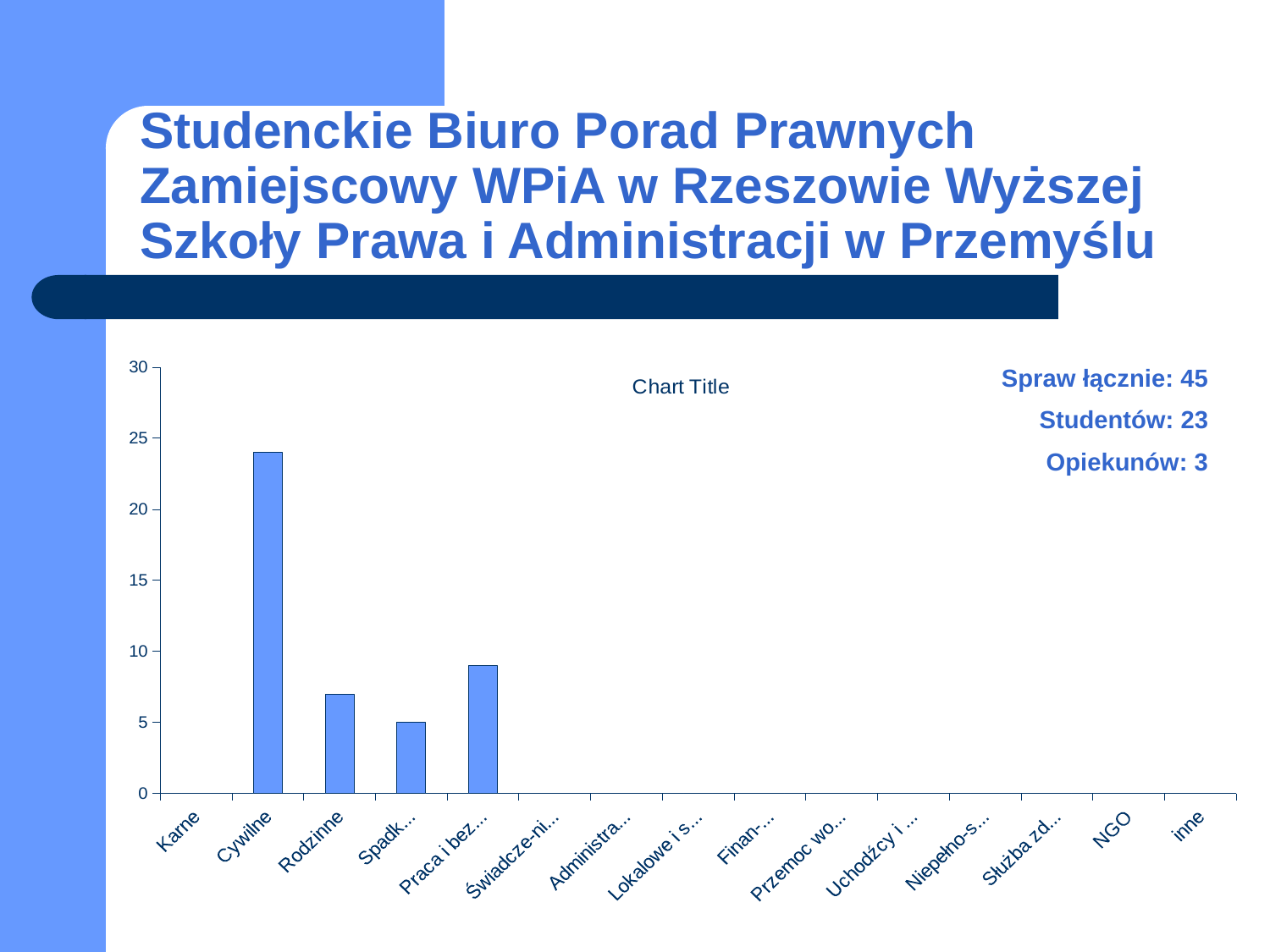
What kind of chart is shown on the slide? bar chart What title is displayed on the chart? Chart Title Is the value for Rodzinne greater or less than 5? greater How many categories are shown on the x axis of the chart? 15 Is the value for Praca i bez... greater or less than 10? less Is the value for Cywilne greater or less than 20? greater Which is larger, the value for Cywilne or the value for Rodzinne? Cywilne What is the value for Spadk... in the chart? 5 Which category has the highest bar in the chart? Cywilne Which is larger, the value for Rodzinne or the value for Spadk...? Rodzinne Which is larger, the value for Praca i bez... or the value for Rodzinne? Praca i bez...